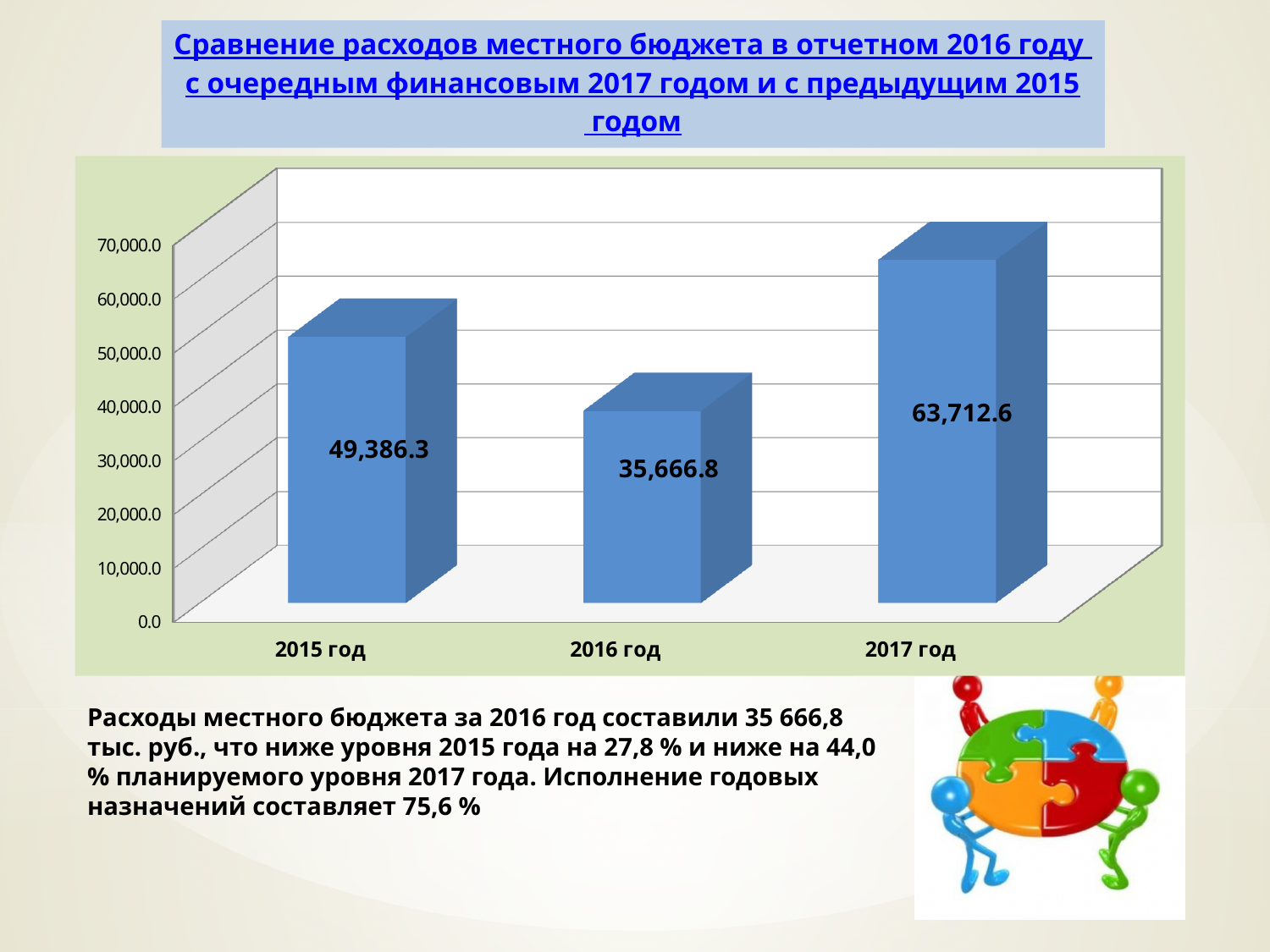
Which is larger, the value for 2015 год or the value for 2017 год? 2017 год How many categories are shown on the x axis? 3 What is the value shown for 2016 год? 35,666.8 What is the value shown for 2017 год? 63,712.6 What is the difference between the values for 2017 год and 2016 год? 28,045.8 What kind of chart is shown on the slide? bar chart Is the value for 2016 год greater or less than 40,000.0? less What is the value shown for 2015 год? 49,386.3 Which year has the highest value? 2017 год Which year has the lowest value? 2016 год What is the difference between the values for 2015 год and 2016 год? 13,719.5 What colour are the bars in the chart? blue